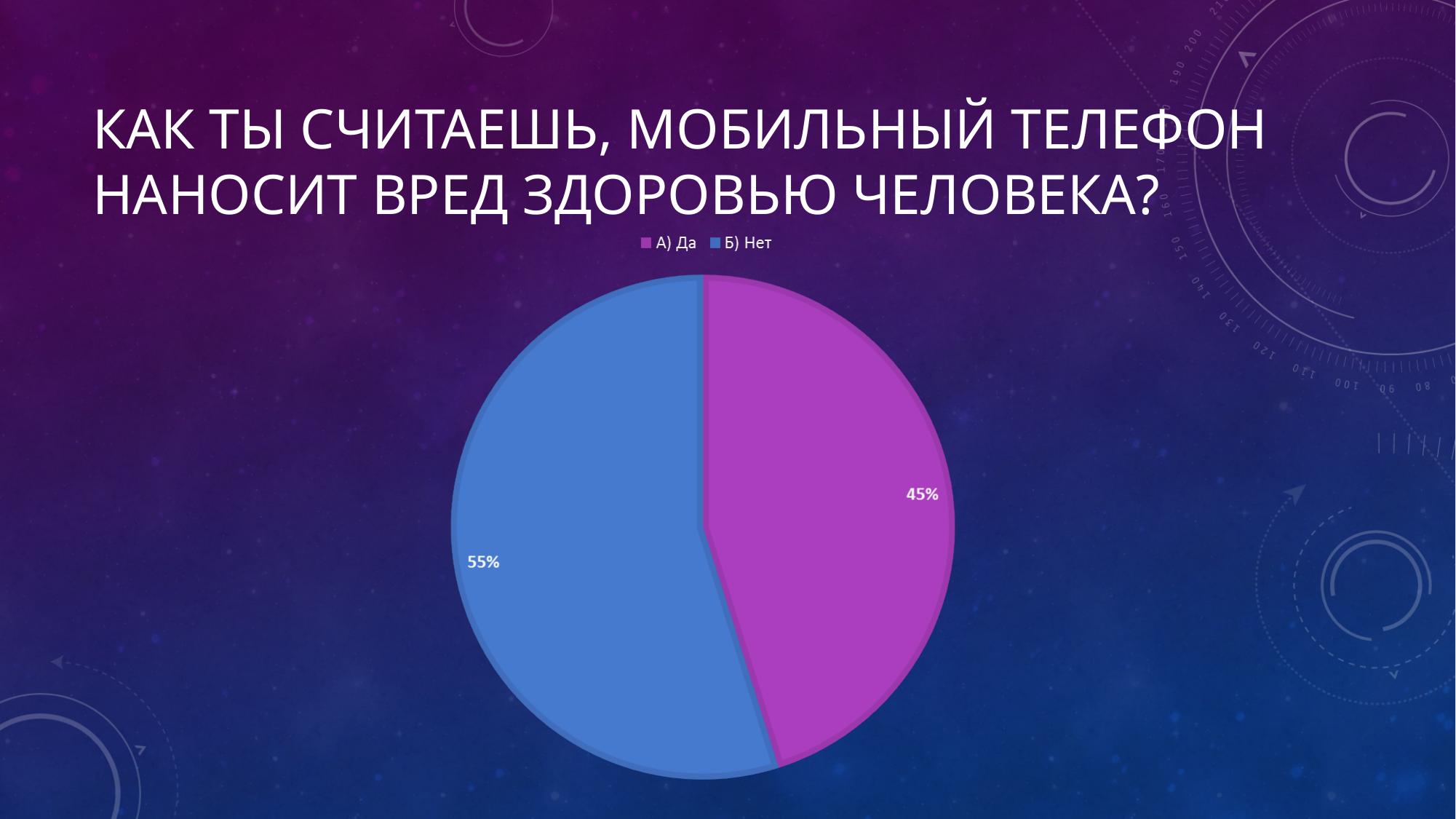
How many entries does the legend list? 2 What kind of chart is shown on the slide? pie chart What share of the pie does "Б) Нет" take? 55% Which slice is the largest? Б) Нет What colour is the slice for "А) Да"? purple What share of the pie does "А) Да" take? 45% Which slice is the smallest? А) Да How many slices does the pie chart have? 2 What is the difference between the shares for "Б) Нет" and "А) Да"? 10% Which is larger, the share for "А) Да" or the share for "Б) Нет"? Б) Нет What colour is the slice for "Б) Нет"? blue